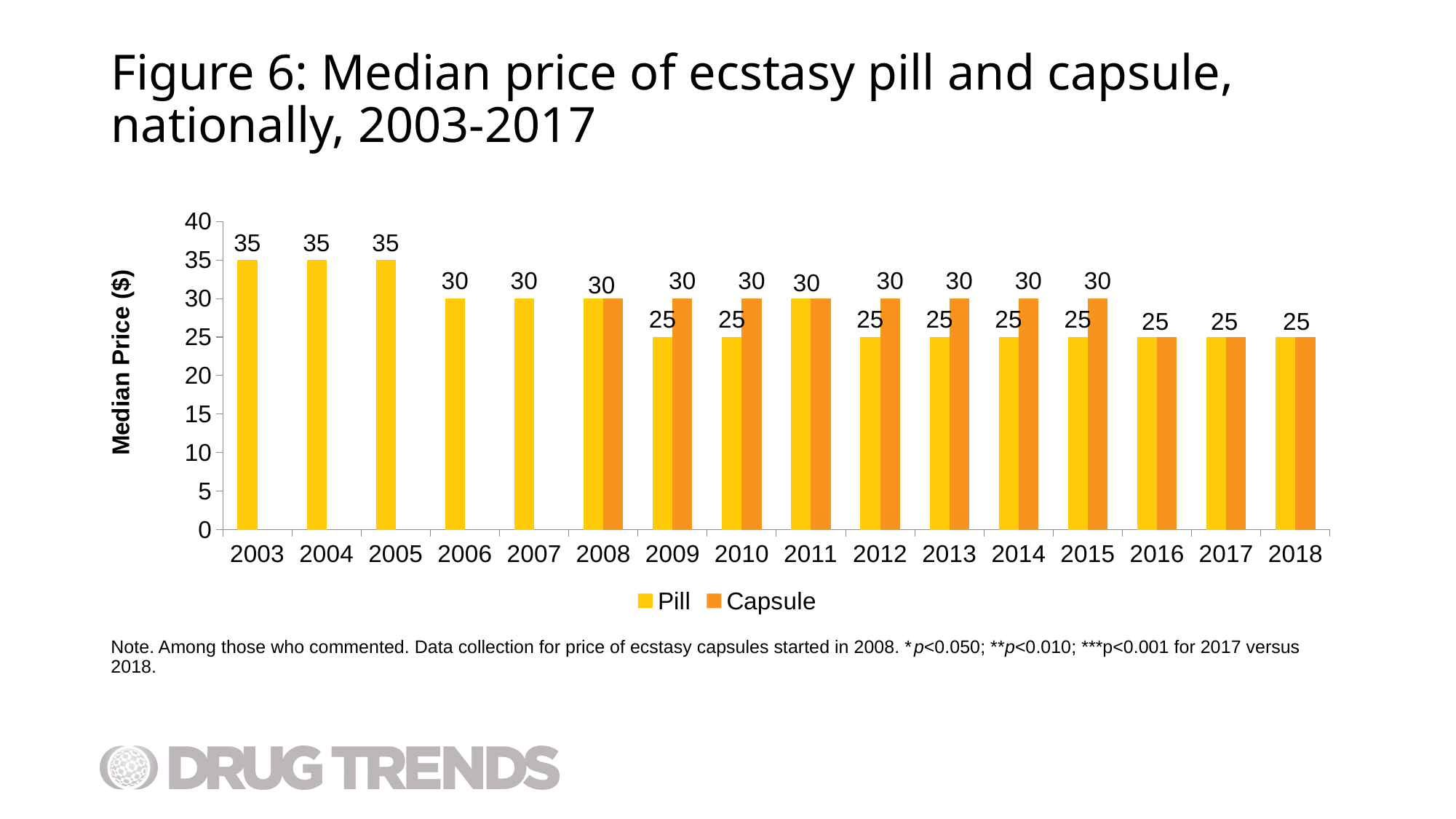
In 2014, which has the higher median price, Pill or Capsule? Capsule How many series does the legend list? 2 What is the highest median pill price shown in the chart? 35 What is the difference between the median capsule price and the median pill price in 2013? 5 What kind of chart is shown on the slide? Bar chart How many years are shown on the x axis? 16 What is the median price of an ecstasy pill in 2009? 25 What is the median price of an ecstasy capsule in 2012? 30 What is the median price of an ecstasy pill in 2003? 35 What is the first year for which a Capsule bar appears in the chart? 2008 What is the median price of an ecstasy pill in 2018? 25 Does the median price of an ecstasy pill rise or fall from 2003 to 2018? Fall